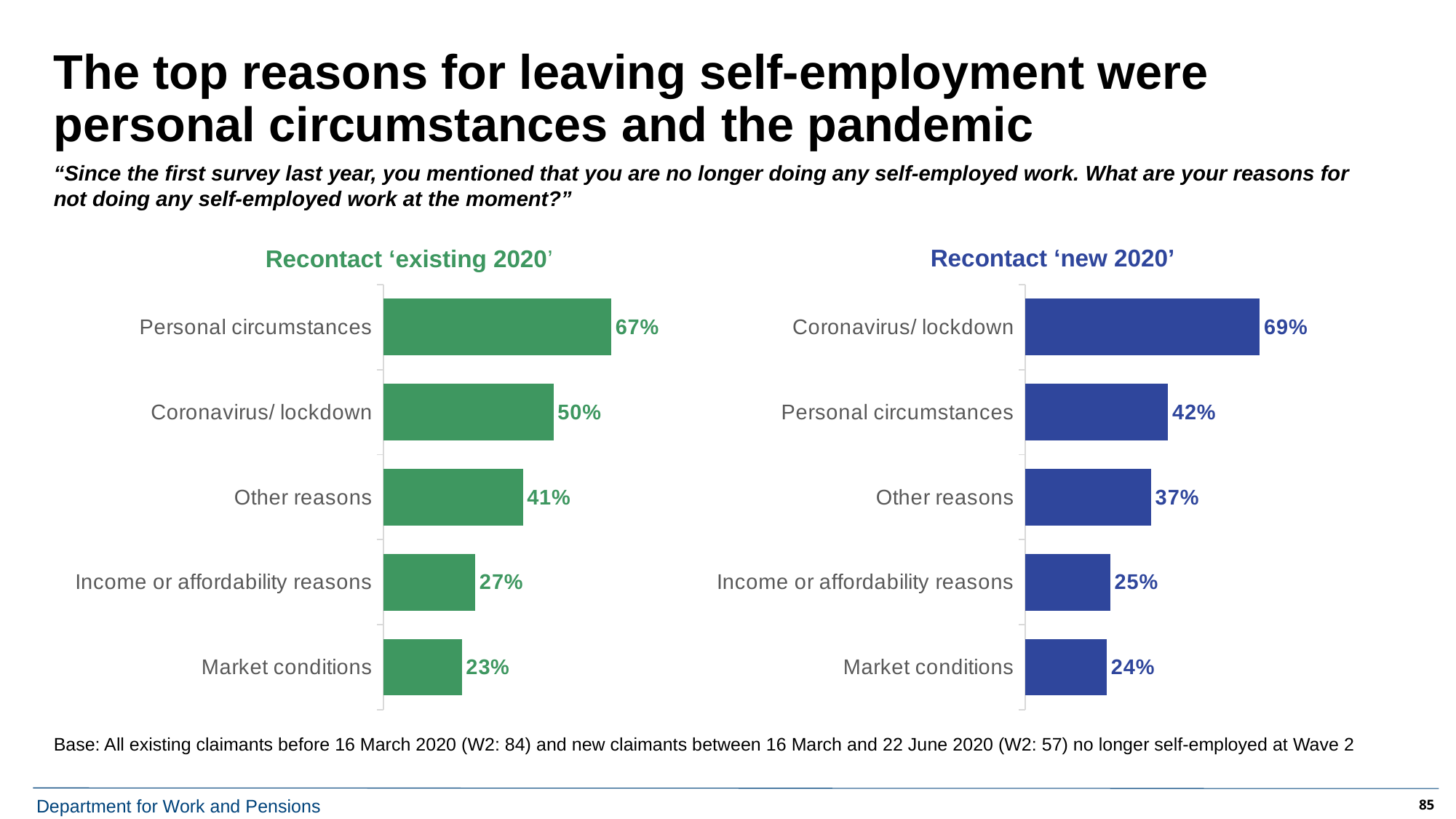
In the 'Recontact ‘existing 2020’' chart, what is the value for Market conditions? 23% In the 'Recontact ‘new 2020’' chart, which reason has the lowest percentage? Market conditions Which is larger: Other reasons in the 'Recontact ‘existing 2020’' chart or Other reasons in the 'Recontact ‘new 2020’' chart? Recontact ‘existing 2020’ (41%) What type of chart is the 'Recontact ‘existing 2020’' chart? Bar chart In the 'Recontact ‘new 2020’' chart, what percentage is shown for Coronavirus/ lockdown? 69% In the 'Recontact ‘existing 2020’' chart, what percentage is shown for Personal circumstances? 67% What colour are the bars in the 'Recontact ‘new 2020’' chart? Blue How many reasons are listed in the 'Recontact ‘new 2020’' chart? 5 In the 'Recontact ‘existing 2020’' chart, what is the difference between Personal circumstances and Coronavirus/ lockdown? 17 percentage points In the 'Recontact ‘new 2020’' chart, what is the value for Income or affordability reasons? 25% In the 'Recontact ‘new 2020’' chart, what is the difference between Coronavirus/ lockdown and Personal circumstances? 27 percentage points In the 'Recontact ‘existing 2020’' chart, which reason has the highest percentage? Personal circumstances